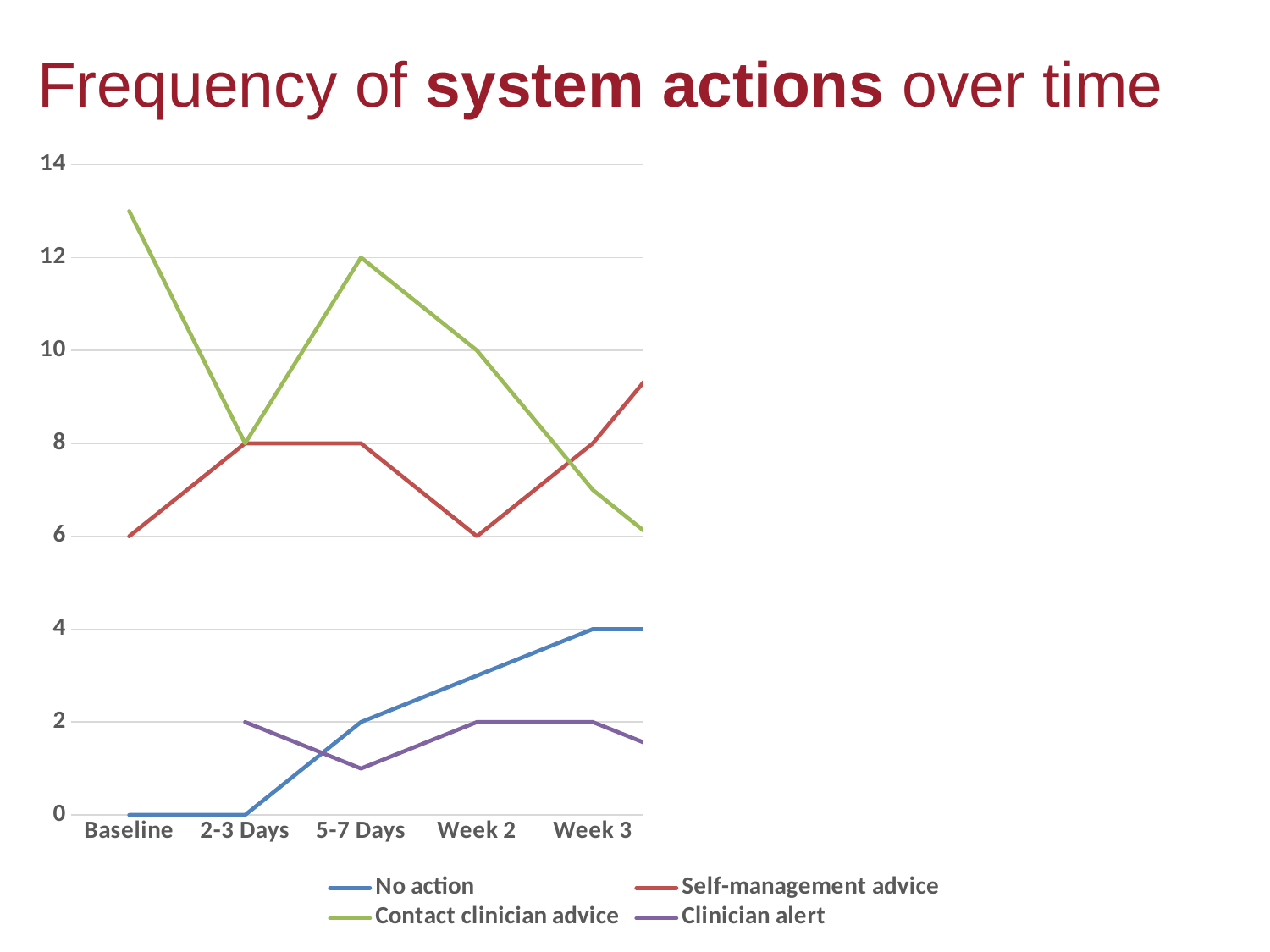
Which series has the highest value at Baseline? Contact clinician advice Which series has the lowest value at Baseline? No action What kind of chart is shown on the slide? Line chart What is the value for No action at Week 3? 4 What is the value for Self-management advice at Baseline? 6 What is the value for Contact clinician advice at 5-7 Days? 12 Is the value for Clinician alert at 5-7 Days greater or less than 2? less How many series does the legend list? 4 What is the value for Clinician alert at Week 2? 2 Is the value for Contact clinician advice at Baseline greater or less than 12? greater At 5-7 Days, which is larger: Contact clinician advice or Self-management advice? Contact clinician advice What is the difference between the Contact clinician advice values at 5-7 Days and Week 2? 2